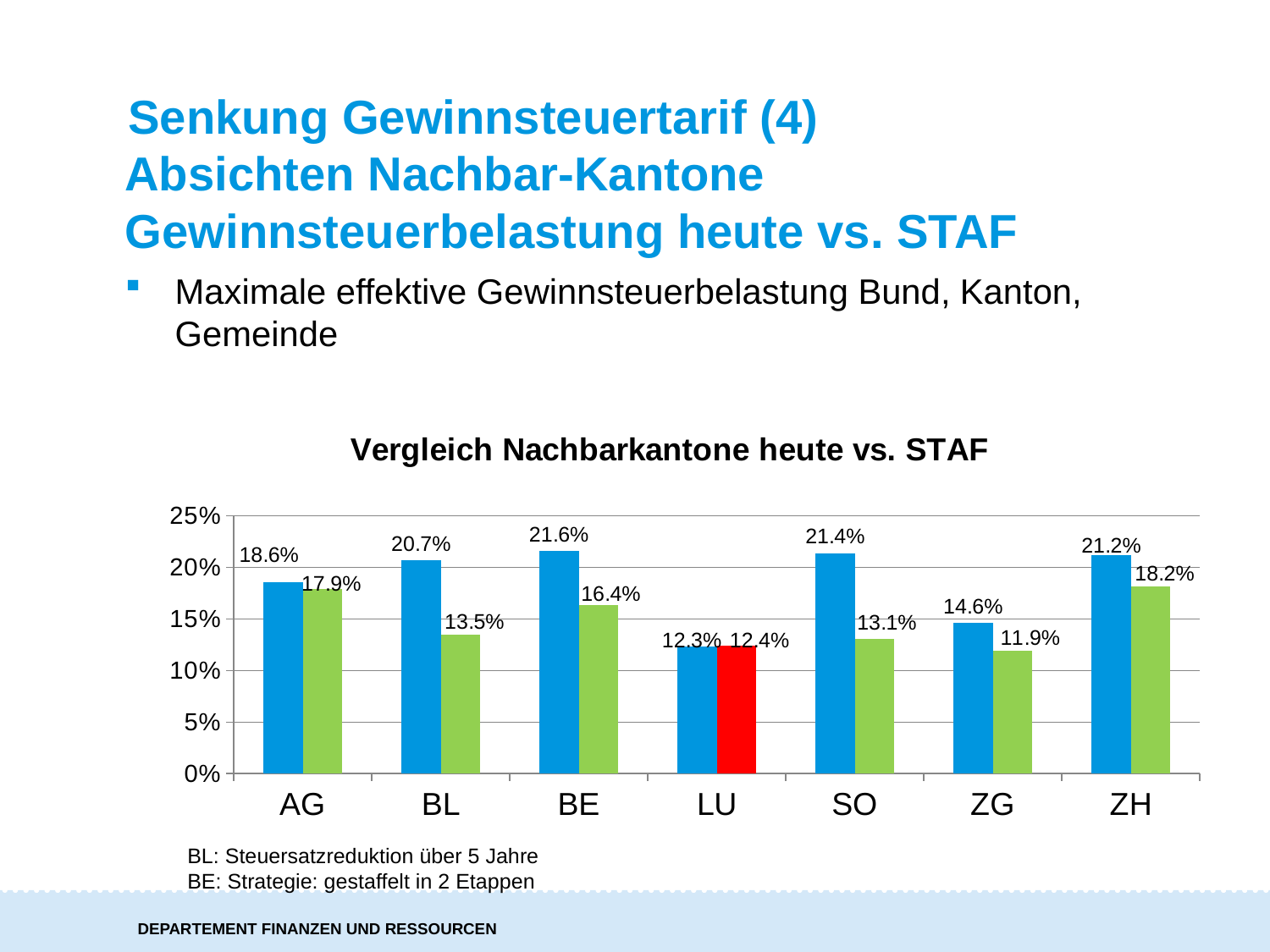
Is the value of the first (blue) bar for ZG greater or less than 15%? less What is the value of the red bar for LU? 12.4% Which canton has the highest value among the first (blue) bars? BE What is the value of the second (green) bar for ZH? 18.2% What kind of chart is shown on the slide? Bar chart What is the title of the chart? Vergleich Nachbarkantone heute vs. STAF What is the value of the second (green) bar for BE? 16.4% What is the difference between the first (blue) bar and the second (green) bar for BL? 7.2 percentage points Which canton has the lowest value among the second (green/red) bars? ZG What is the value of the first (blue) bar for AG? 18.6% How many cantons are shown on the x axis of the chart? 7 Which is larger: the first (blue) bar for SO or the first (blue) bar for ZG? SO